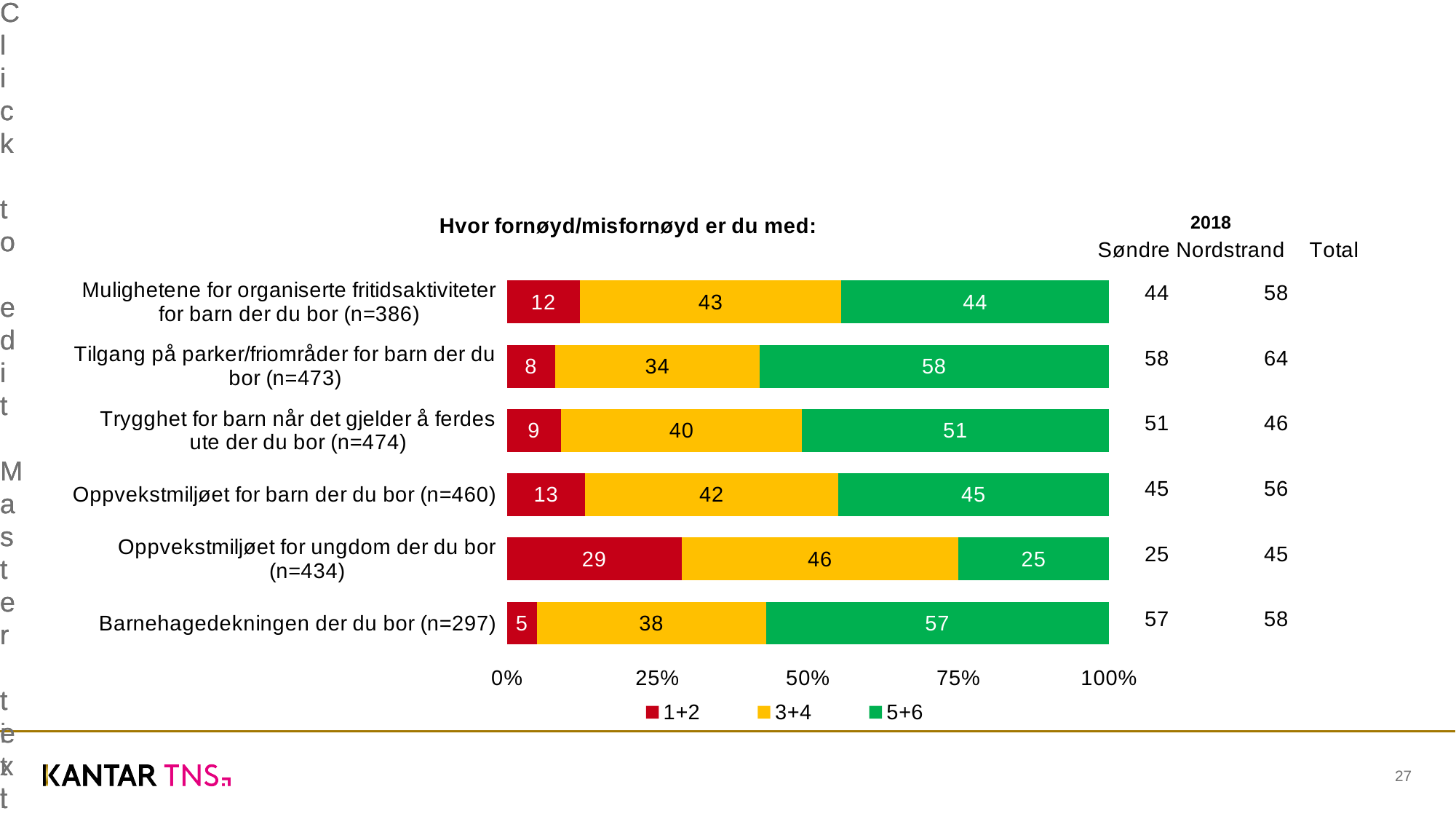
What is the difference between the 5+6 values for "Tilgang på parker/friområder for barn der du bor (n=473)" and "Oppvekstmiljøet for ungdom der du bor (n=434)"? 33 What is the title of the chart? Hvor fornøyd/misfornøyd er du med: How many categories are shown in the chart? 6 How many series does the legend list? 3 Which category has the highest 5+6 value? Tilgang på parker/friområder for barn der du bor (n=473) What is the 5+6 value for "Barnehagedekningen der du bor (n=297)"? 57 What is the total of the stacked bar for "Oppvekstmiljøet for barn der du bor (n=460)"? 100 Which category has the lowest 1+2 value? Barnehagedekningen der du bor (n=297) What is the 1+2 value for "Oppvekstmiljøet for ungdom der du bor (n=434)"? 29 What is the 3+4 value for "Tilgang på parker/friområder for barn der du bor (n=473)"? 34 Which is larger: the 3+4 value for "Oppvekstmiljøet for ungdom der du bor (n=434)" or the 3+4 value for "Trygghet for barn når det gjelder å ferdes ute der du bor (n=474)"? Oppvekstmiljøet for ungdom der du bor (n=434) What kind of chart is shown on the slide? Stacked bar chart